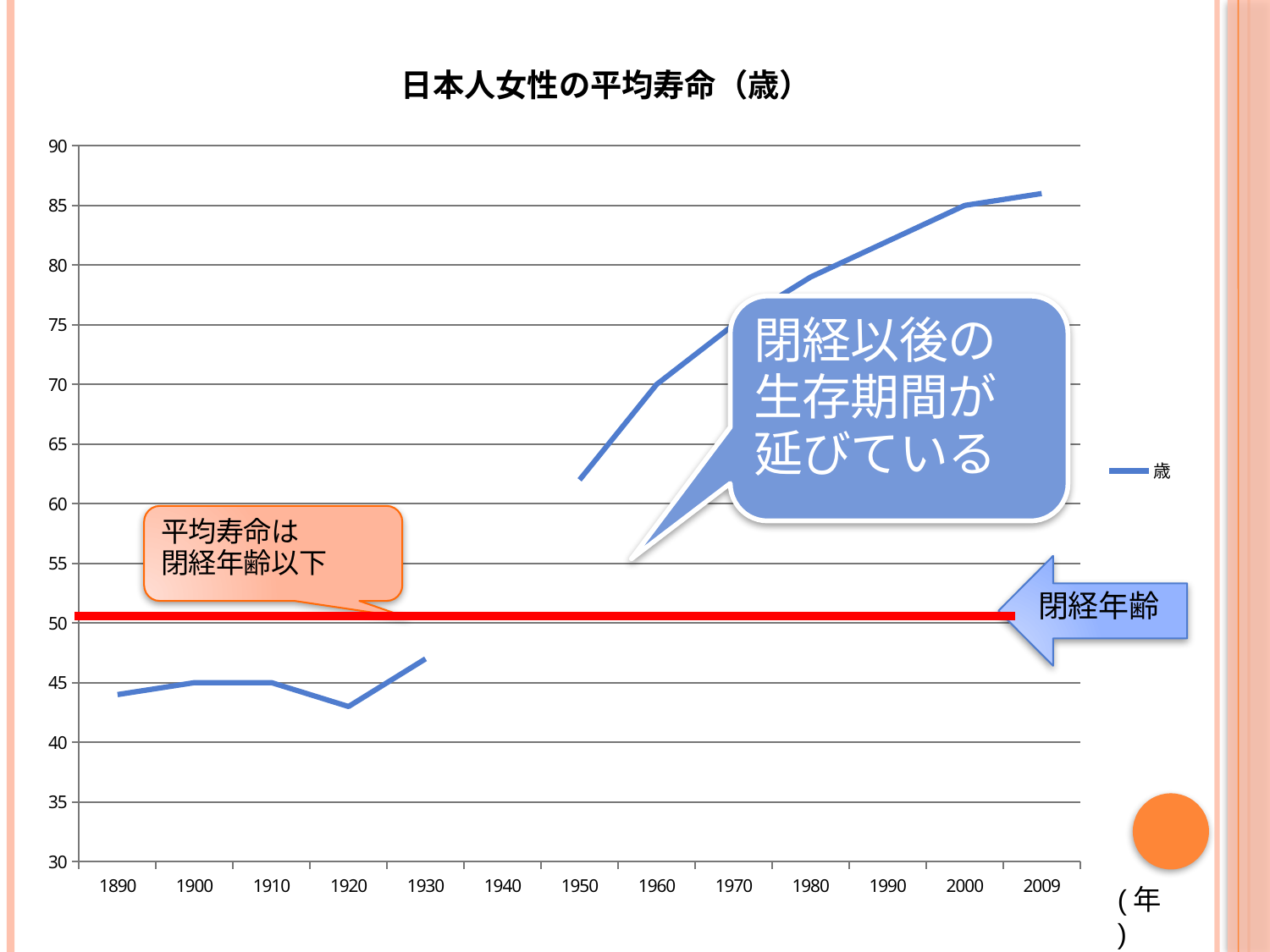
Which year has the lowest value on the line? 1920 Does the line rise or fall from 1950 to 2009? rise How many series does the legend list? 1 Is the value for 1920 greater or less than 45? less Which year has the highest value on the line? 2009 What is the title of the chart? 日本人女性の平均寿命（歳） What is the value for 1960? 70 What kind of chart is shown on the slide? line chart Is the value for 2009 greater or less than 85? greater Is the value for 1950 greater or less than 60? greater Which is larger, the value for 1930 or the value for 1890? 1930 What is the legend entry for the plotted line? 歳